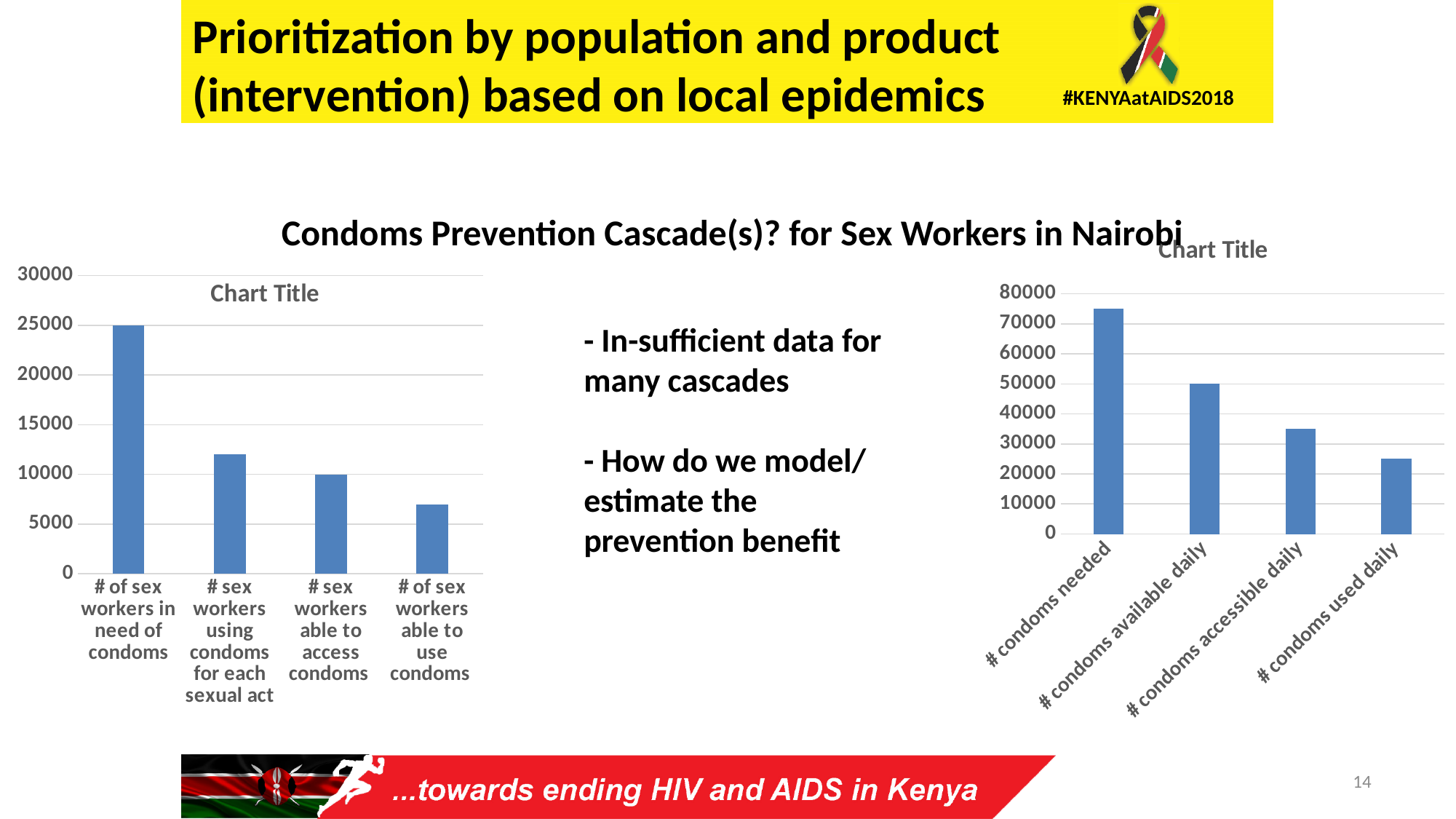
On the left chart, what is the value for '# of sex workers in need of condoms'? 25000 On the left chart, is the value for '# sex workers using condoms for each sexual act' greater or less than 10000? greater On the right chart, which category has the lowest value? # condoms used daily On the left chart, which category has the lowest value? # of sex workers able to use condoms What type of chart is the left chart? Bar chart On the left chart, which category has the highest value? # of sex workers in need of condoms On the right chart, is the value for '# condoms needed' greater or less than 70000? greater On the left chart, what is the value for '# sex workers able to access condoms'? 10000 On the right chart, is the value for '# condoms accessible daily' greater or less than 40000? less On the right chart, which category has the highest value? # condoms needed On the right chart, what is the value for '# condoms available daily'? 50000 How many categories are shown on the right chart? 4